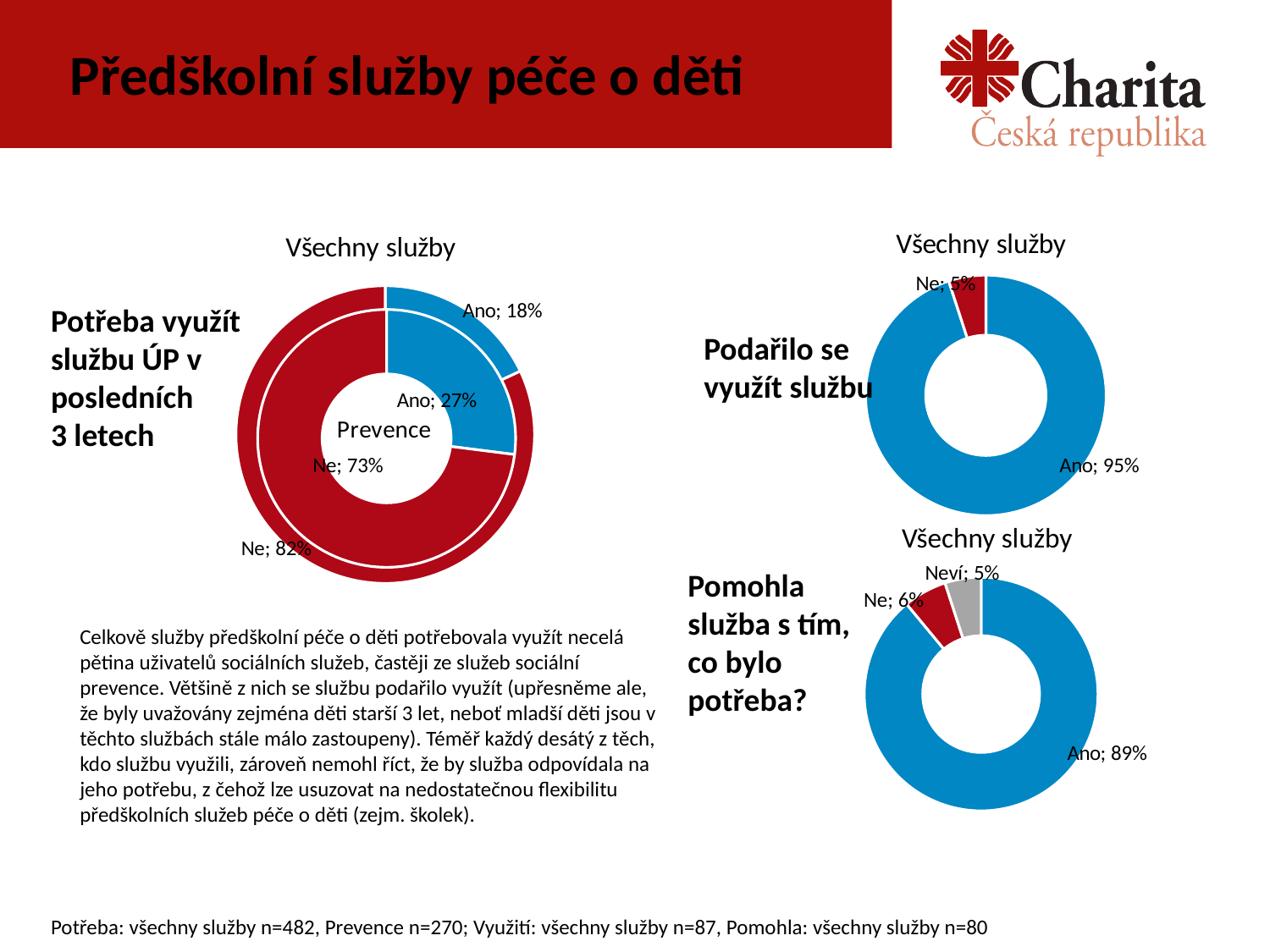
In the bottom-right chart 'Pomohla služba s tím, co bylo potřeba?', what is the 'Ano' share? 89% In the bottom-right chart 'Pomohla služba s tím, co bylo potřeba?', what is the 'Neví' share? 5% What kind of chart is the top-right chart 'Podařilo se využít službu'? Doughnut (pie) chart In the top-right chart 'Podařilo se využít službu', what is the 'Ne' share? 5% In the top-right chart 'Podařilo se využít službu', what is the 'Ano' share? 95% In the left chart 'Potřeba využít službu ÚP v posledních 3 letech', what is the 'Ano' share for 'Prevence' (inner ring)? 27% In the left chart 'Potřeba využít službu ÚP v posledních 3 letech', what is the 'Ne' share for 'Všechny služby' (outer ring)? 82% In the left chart 'Potřeba využít službu ÚP v posledních 3 letech', what is the 'Ano' share for 'Všechny služby' (outer ring)? 18% In the bottom-right chart 'Pomohla služba s tím, co bylo potřeba?', how many categories are shown? 3 In the left chart 'Potřeba využít službu ÚP v posledních 3 letech', what is the 'Ne' share for 'Prevence' (inner ring)? 73% In the bottom-right chart 'Pomohla služba s tím, co bylo potřeba?', which category has the smallest share? Neví In the left chart 'Potřeba využít službu ÚP v posledních 3 letech', what is the difference between the 'Ano' share for 'Prevence' and the 'Ano' share for 'Všechny služby'? 9 percentage points